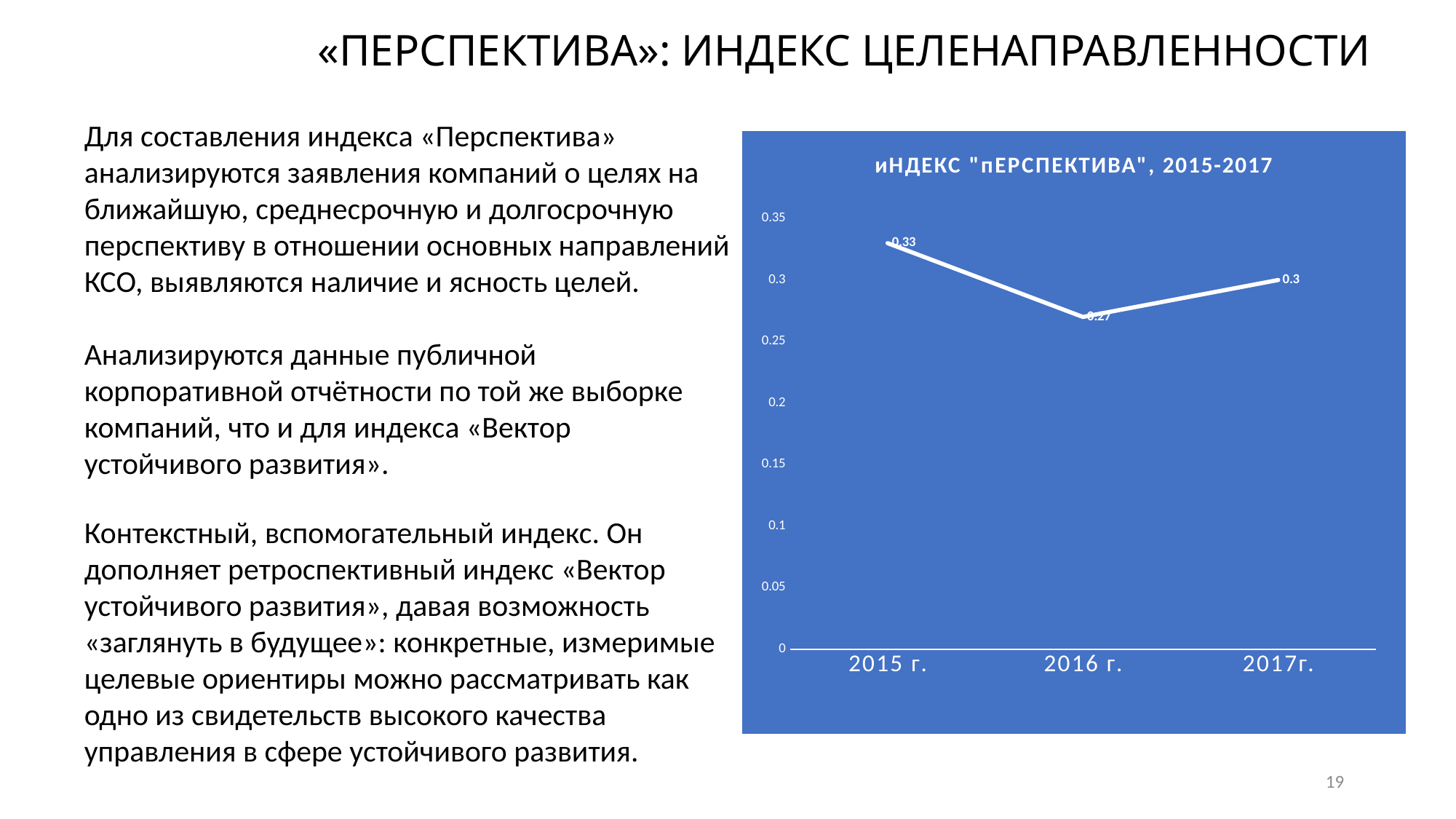
What is the difference between the index values for 2015 г. and 2016 г.? 0.06 What kind of chart is shown on the slide? line chart Which year has the highest index value? 2015 г. Is the value for 2016 г. greater or less than 0.3? less What is the difference between the index values for 2017г. and 2016 г.? 0.03 What is the value of the index for 2016 г.? 0.27 How many years are plotted on the chart? 3 What is the title of the chart? иНДЕКС "пЕРСПЕКТИВА", 2015-2017 What is the value of the index for 2015 г.? 0.33 Which year has the lowest index value? 2016 г. Which is larger, the index value for 2015 г. or for 2017г.? 2015 г. What is the value of the index for 2017г.? 0.3